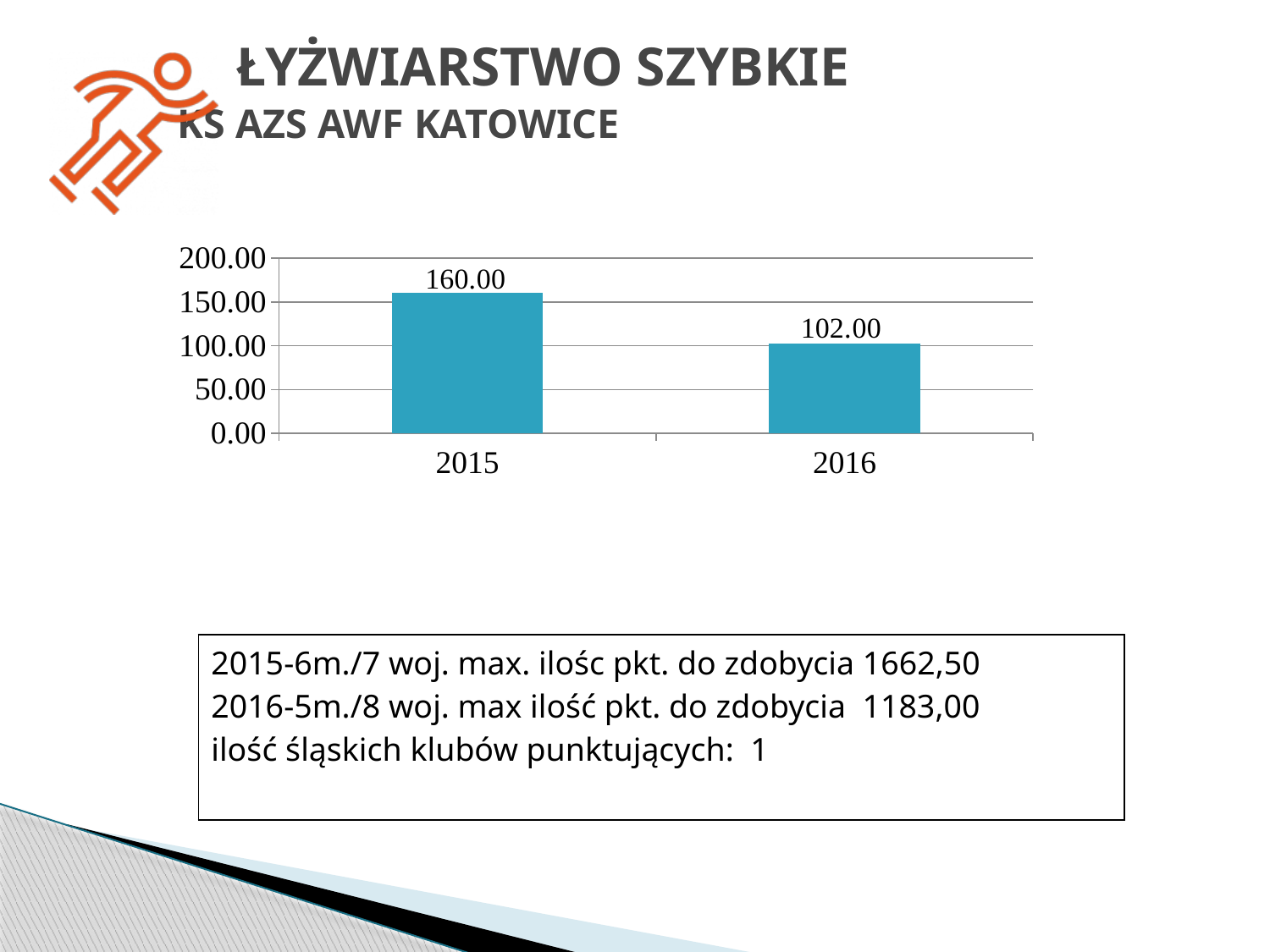
What is the difference between the values for 2015 and 2016? 58.00 What kind of chart is shown on the slide? bar chart Is the value for 2016 greater or less than 150.00? less What is the value for 2015? 160.00 Which is larger, the value for 2015 or the value for 2016? 2015 What is the value for 2016? 102.00 Which year has the highest value? 2015 What is the maximum value shown on the y axis? 200.00 Which year has the lowest value? 2016 Is the value for 2015 greater or less than 150.00? greater How many years are shown on the x axis? 2 Do the values rise or fall from 2015 to 2016? fall